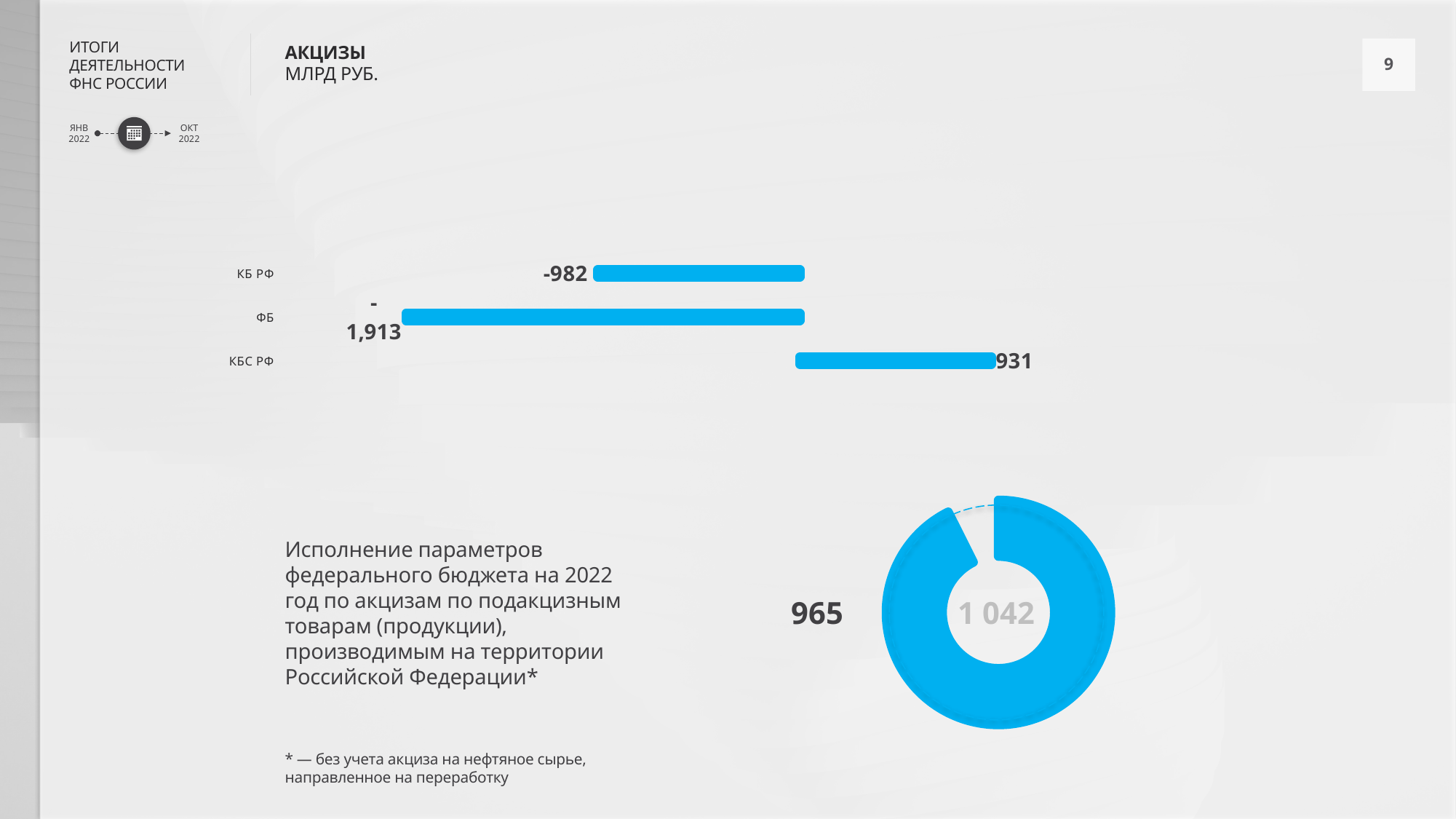
What kind of chart is the lower chart on the slide? doughnut chart In the bar chart, which has the larger value, КБ РФ or ФБ? КБ РФ In the bar chart, what is the value for КБС РФ? 931 In the doughnut chart, what value is labelled next to the ring? 965 In the bar chart, which category has the lowest value? ФБ In the doughnut chart, what value is printed in the centre? 1 042 How many categories does the bar chart show? 3 In the bar chart, what is the difference between the values for КБС РФ and КБ РФ? 1,913 In the bar chart, what is the value for КБ РФ? -982 What kind of chart is the upper chart on the slide? bar chart In the bar chart, what is the value for ФБ? -1,913 In the bar chart, which category has the highest value? КБС РФ